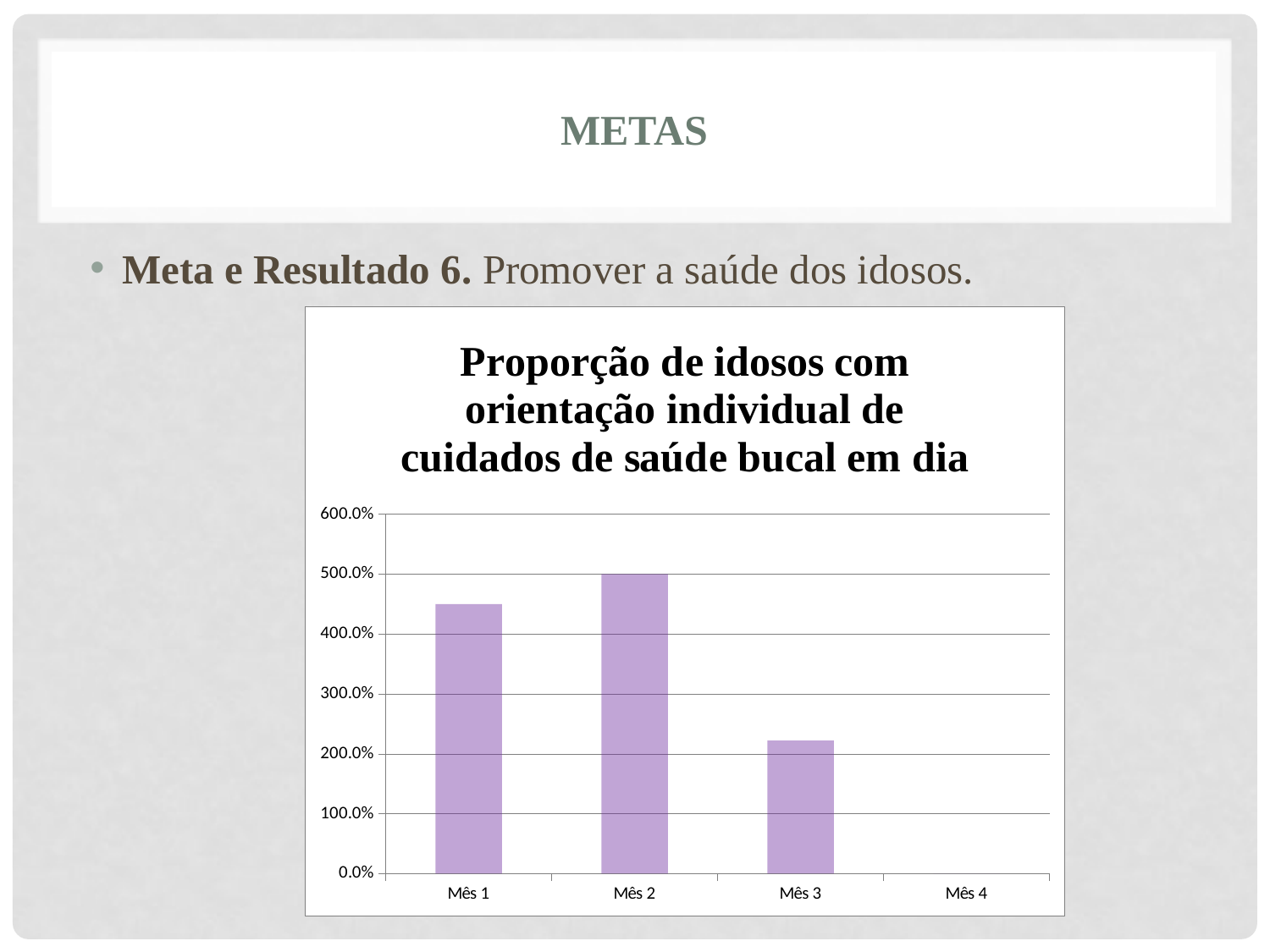
Is the value for Mês 3 greater or less than 200.0%? greater Is the value for Mês 3 greater or less than 300.0%? less Which is larger, the value for Mês 1 or the value for Mês 3? Mês 1 What is the title of the chart? Proporção de idosos com orientação individual de cuidados de saúde bucal em dia How many categories are shown on the x axis of the chart? 4 Is the value for Mês 1 greater or less than 400.0%? greater What is the highest value shown on the y axis of the chart? 600.0% What is the value for Mês 2? 500.0% Do the values rise or fall from Mês 2 to Mês 4? fall What kind of chart is shown on the slide? bar chart Which month has the highest value in the chart? Mês 2 Which month has the lowest value in the chart? Mês 4